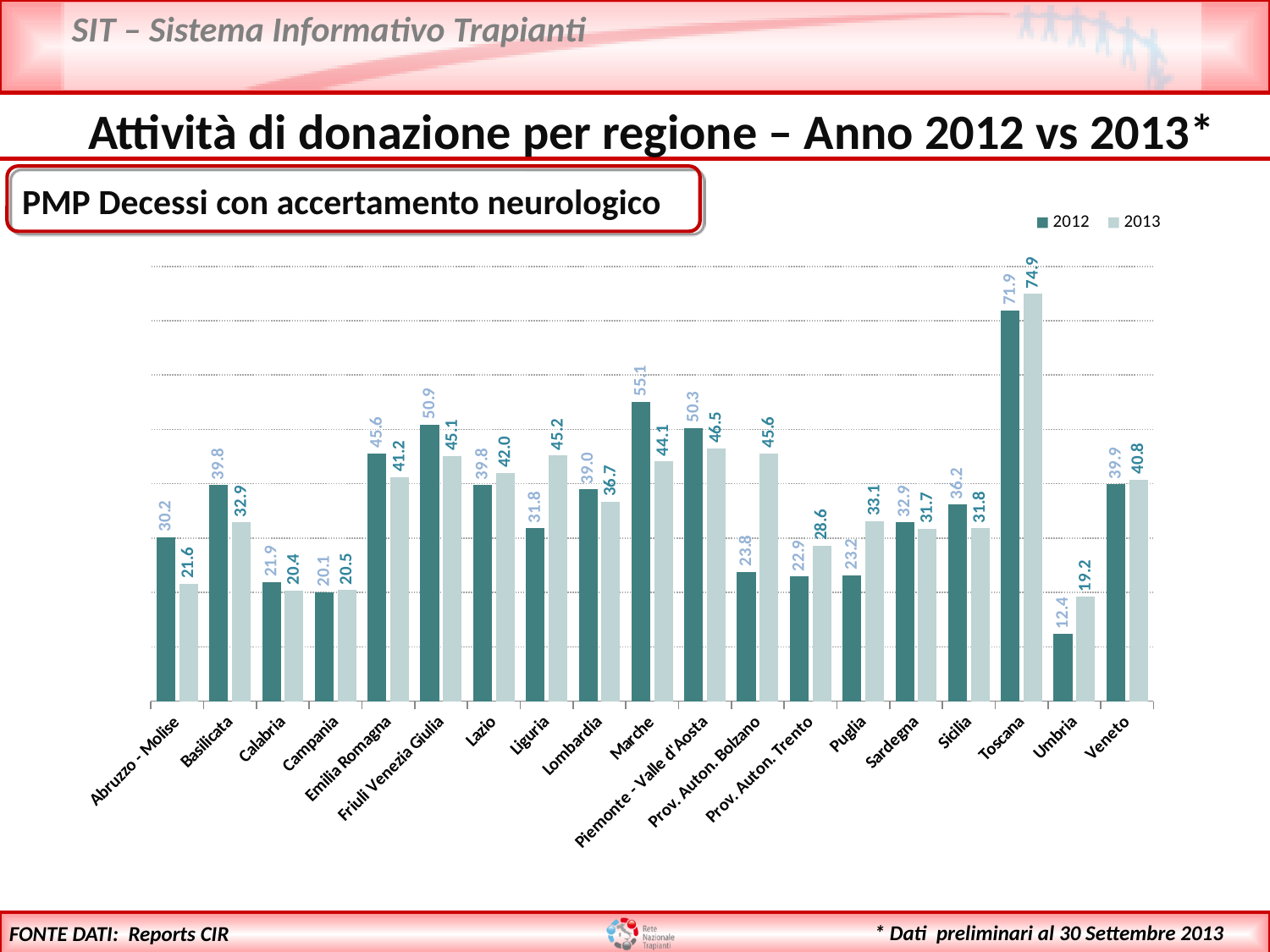
Which is larger for Friuli Venezia Giulia, the 2012 value or the 2013 value? 2012 What is the 2013 value for Prov. Auton. Bolzano? 45.6 Which region has the highest 2013 value? Toscana What is the 2012 value for Umbria? 12.4 What is the 2012 value for Marche? 55.1 How many regions are shown on the x axis? 19 Which region has the lowest 2012 value? Umbria What kind of chart is shown on the slide? Bar chart What is the difference between the 2013 and 2012 values for Liguria? 13.4 What is the difference between the 2013 and 2012 values for Toscana? 3.0 How many series does the legend list? 2 Which is larger for Puglia, the 2012 value or the 2013 value? 2013